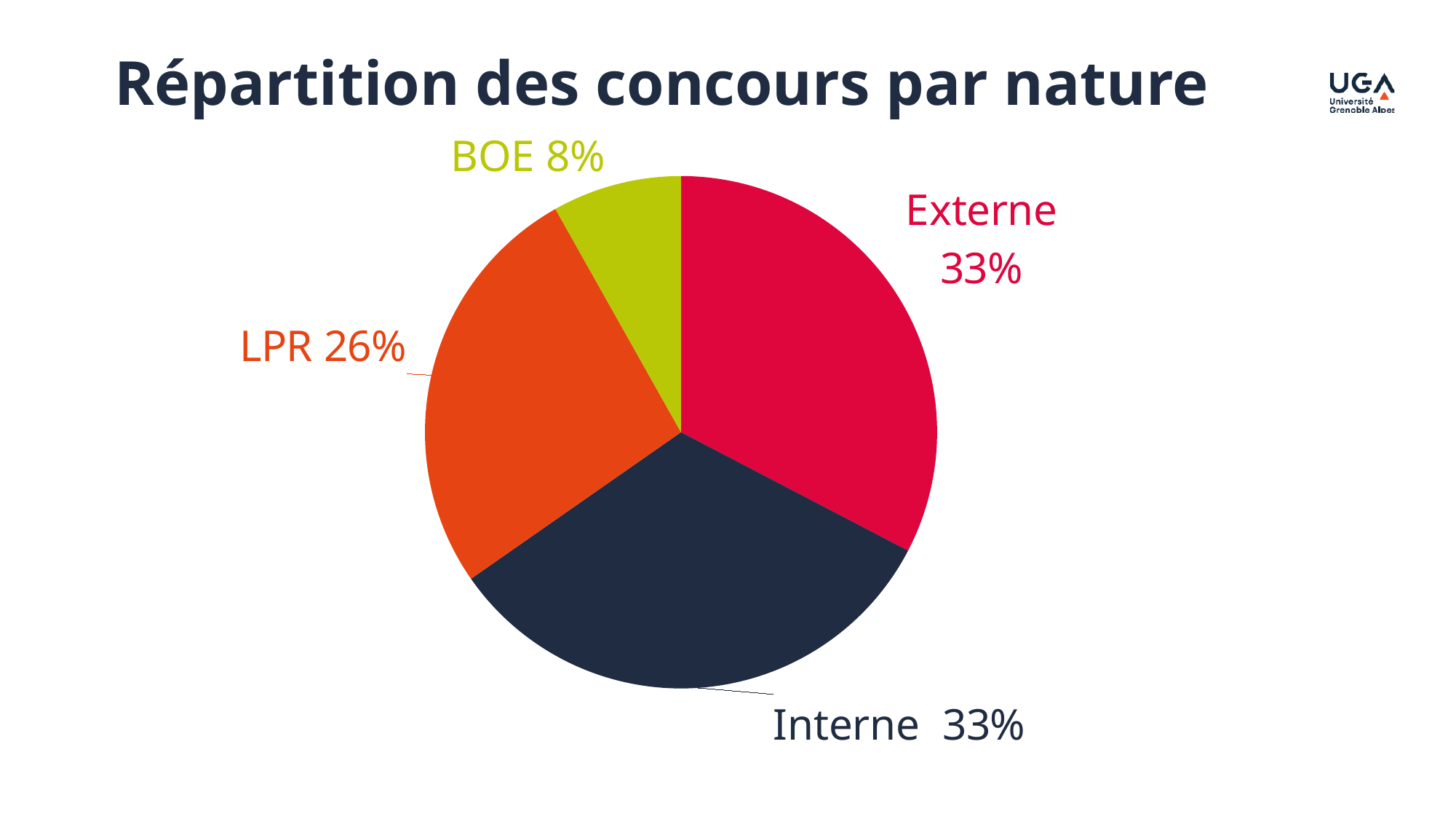
What is the difference in percentage points between Externe and LPR? 7 Which is larger, the LPR slice or the BOE slice? LPR What is the title of the chart? Répartition des concours par nature What is the difference in percentage points between LPR and BOE? 18 Which is larger, the Interne slice or the LPR slice? Interne What share of the pie does Externe represent? 33% Which category has the smallest slice of the pie? BOE What share of the pie does BOE represent? 8% What share of the pie does Interne represent? 33% What kind of chart is shown on the slide? Pie chart How many categories are shown in the pie chart? 4 What share of the pie does LPR represent? 26%